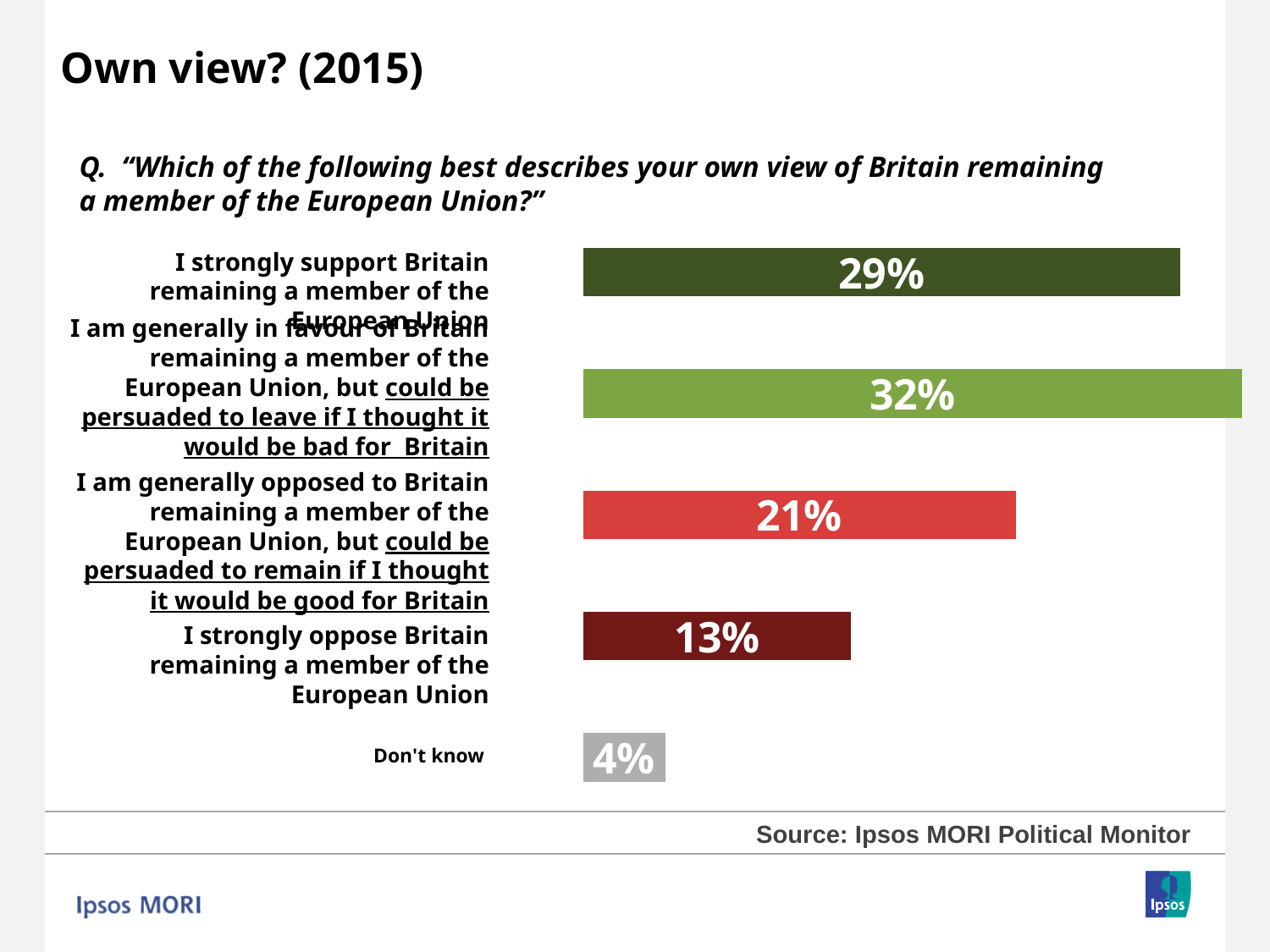
What is the combined percentage of respondents who strongly support or are generally in favour of Britain remaining? 61% What percentage of respondents strongly support Britain remaining a member of the European Union? 29% What percentage of respondents are generally in favour of Britain remaining but could be persuaded to leave? 32% What percentage of respondents strongly oppose Britain remaining a member of the European Union? 13% What is the difference between the percentage who strongly support remaining and the percentage who strongly oppose remaining? 16% What percentage of respondents are generally opposed to Britain remaining but could be persuaded to remain? 21% How many response options are shown in the chart? 5 Which response option has the lowest percentage? Don't know Which is larger: the percentage who strongly support remaining or the percentage who are generally opposed but could be persuaded to remain? I strongly support Britain remaining a member of the European Union Which response option has the highest percentage? I am generally in favour of Britain remaining a member of the European Union, but could be persuaded to leave if I thought it would be bad for Britain What kind of chart is shown on the slide? Bar chart What percentage of respondents answered 'Don't know'? 4%